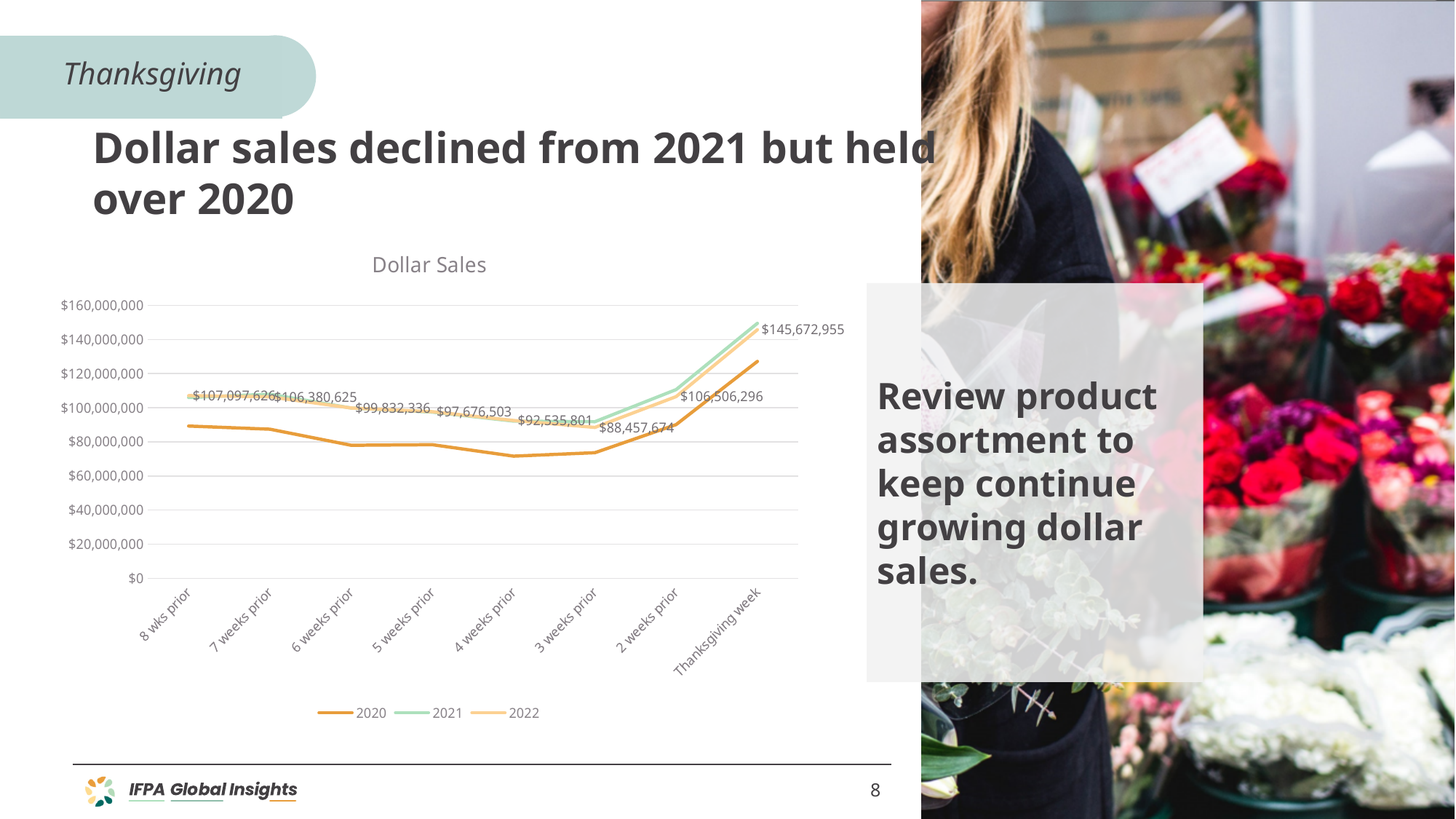
How many time points are plotted along the x axis of the Dollar Sales chart? 8 What is the labelled 2022 dollar sales value for 2 weeks prior? $106,506,296 At which time point is the labelled 2022 dollar sales value highest? Thanksgiving week What is the labelled 2022 dollar sales value for 3 weeks prior? $88,457,674 At which time point is the labelled 2022 dollar sales value lowest? 3 weeks prior What is the difference between the labelled 2022 values for Thanksgiving week and 2 weeks prior? $39,166,659 What kind of chart is shown on the slide? Line chart Does the 2020 line rise or fall from 8 wks prior to 4 weeks prior? Falls What is the labelled 2022 dollar sales value for Thanksgiving week? $145,672,955 Is the 2020 dollar sales value at 4 weeks prior greater or less than $80,000,000? less How many series does the legend of the Dollar Sales chart list? 3 At Thanksgiving week, which series has the higher dollar sales, 2020 or 2021? 2021